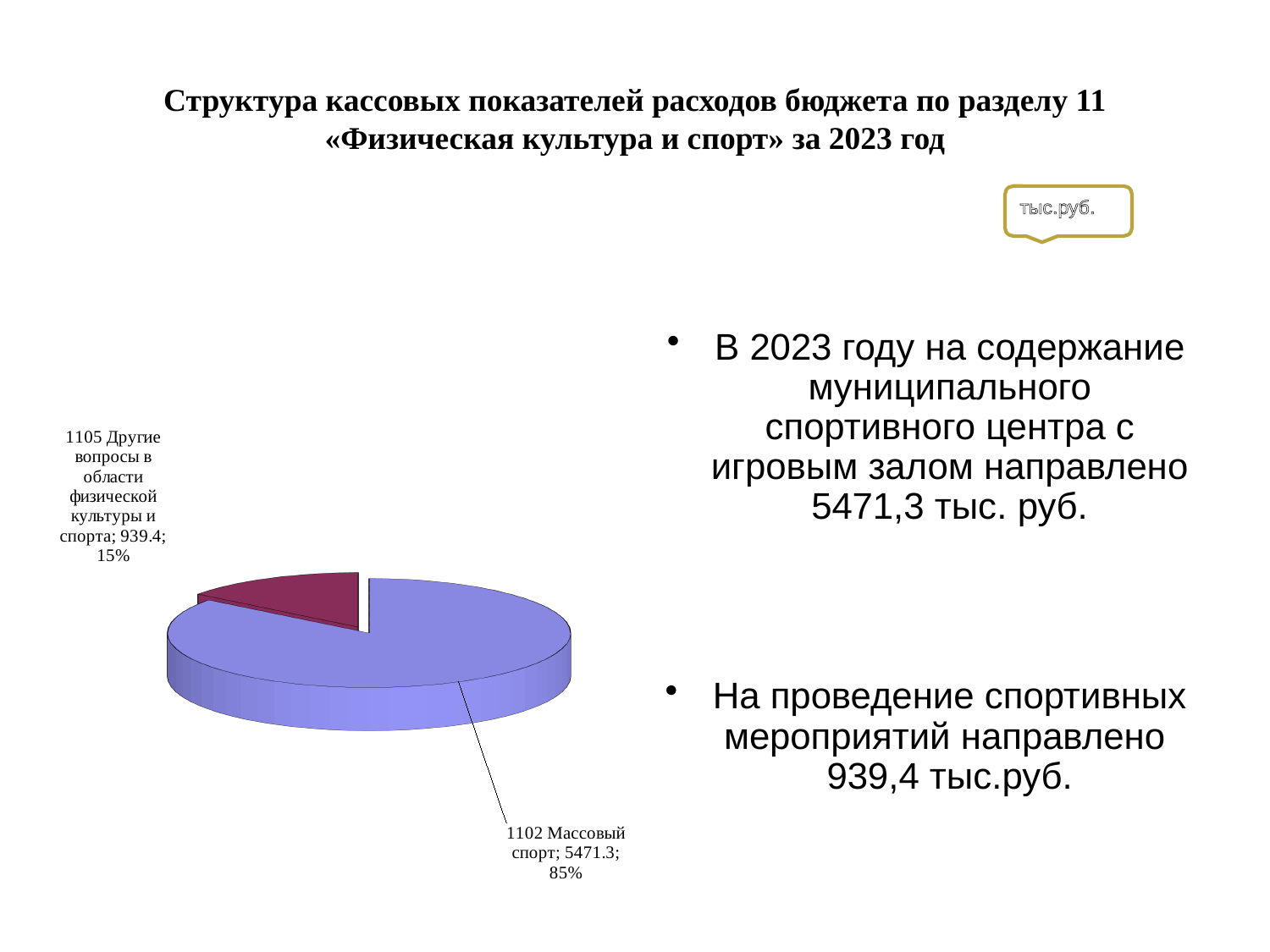
What is the value for 1102 Массовый спорт? 5471.3 What kind of chart is shown on the slide? pie chart What share of the pie does 1105 Другие вопросы в области физической культуры и спорта represent? 15% Which is larger: the value for 1102 Массовый спорт or for 1105 Другие вопросы в области физической культуры и спорта? 1102 Массовый спорт What is the difference between the values for 1102 Массовый спорт and 1105 Другие вопросы в области физической культуры и спорта? 4531.9 What share of the pie does 1102 Массовый спорт represent? 85% What is the value for 1105 Другие вопросы в области физической культуры и спорта? 939.4 What unit is indicated in the callout next to the chart? тыс.руб. Which category has the smallest slice of the pie? 1105 Другие вопросы в области физической культуры и спорта What is the total of the two slices in the pie chart? 6410.7 How many slices does the pie chart have? 2 Which category has the largest slice of the pie? 1102 Массовый спорт